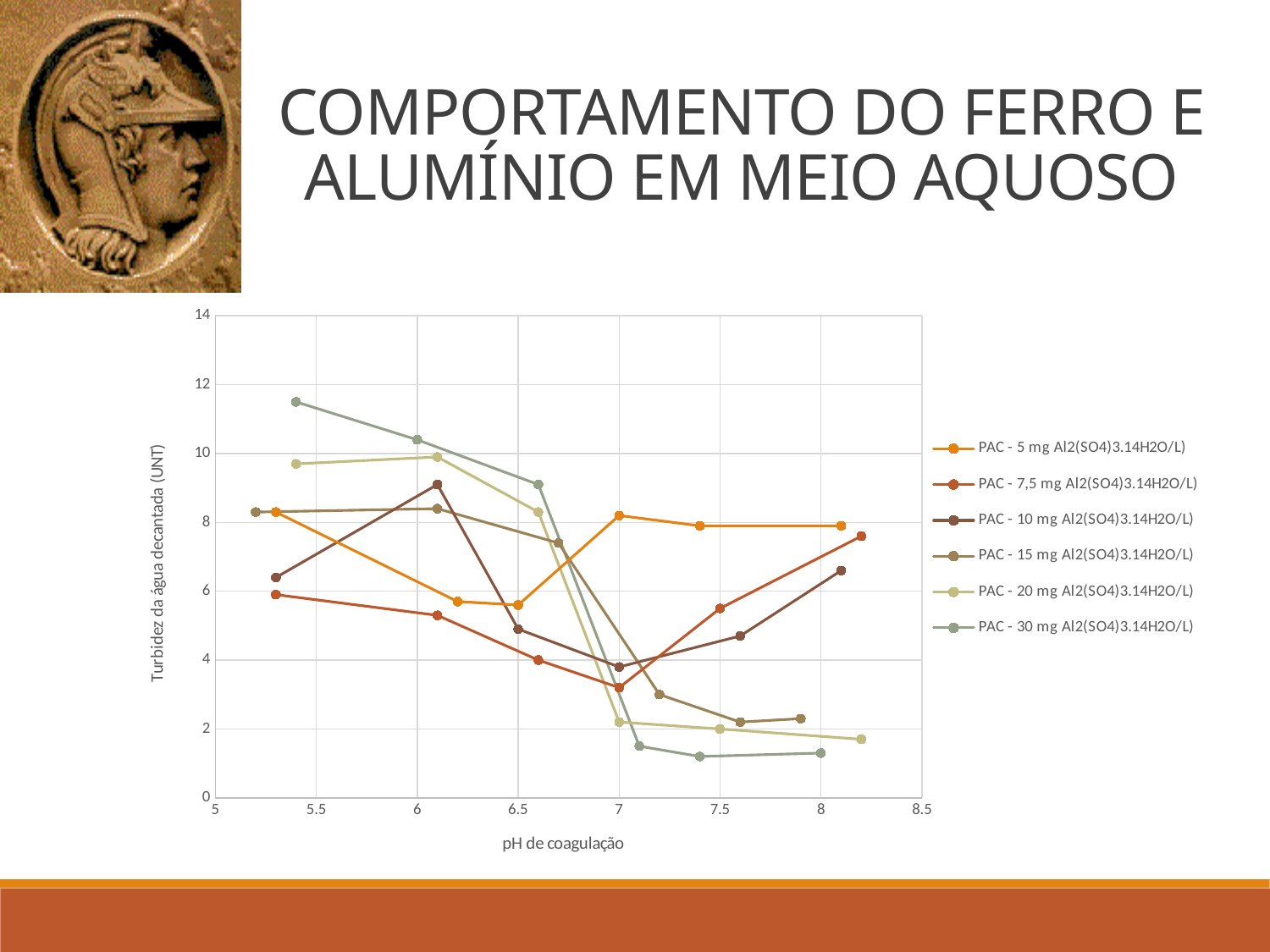
Do the values for PAC - 30 mg Al2(SO4)3.14H2O/L generally rise or fall as pH increases? fall Is the value for PAC - 7,5 mg Al2(SO4)3.14H2O/L at pH 7 greater or less than 4? less How many series does the legend list? 6 What kind of chart is shown on the slide? line chart Is the value for PAC - 20 mg Al2(SO4)3.14H2O/L at pH 6.1 greater or less than 8? greater Which series reaches the highest turbidity value on the chart? PAC - 30 mg Al2(SO4)3.14H2O/L Is the value for PAC - 30 mg Al2(SO4)3.14H2O/L at pH 7.4 greater or less than 2? less At pH 7, which series has the larger value: PAC - 5 mg Al2(SO4)3.14H2O/L or PAC - 20 mg Al2(SO4)3.14H2O/L? PAC - 5 mg Al2(SO4)3.14H2O/L What is the title of the x axis? pH de coagulação What is the title of the y axis? Turbidez da água decantada (UNT)